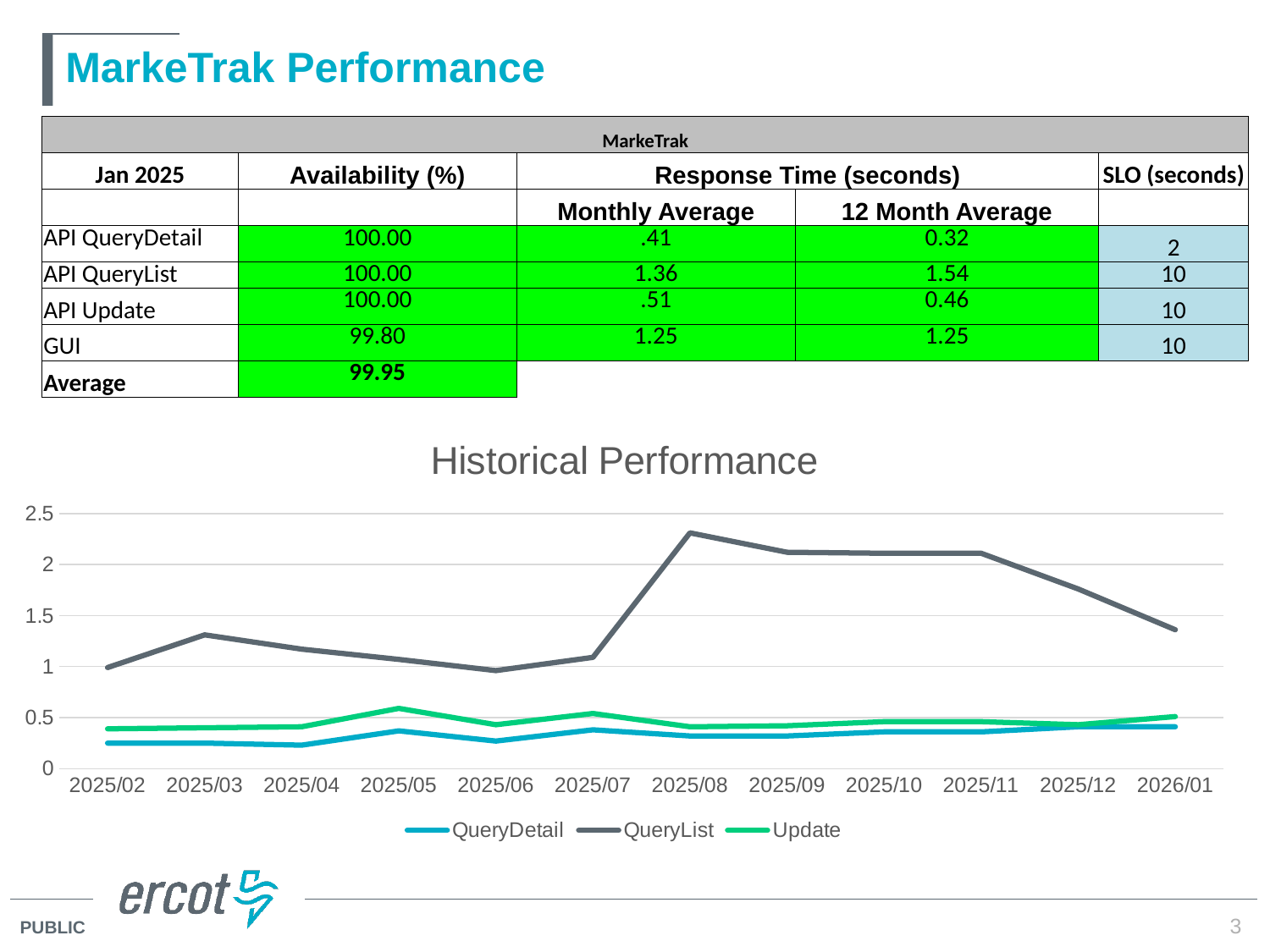
How many months are plotted along the x axis of the Historical Performance chart? 12 In the Historical Performance chart, is the QueryList value for 2025/08 greater or less than 2? greater In the Historical Performance chart, is the QueryDetail value for 2025/02 greater or less than 0.5? less How many series does the legend of the Historical Performance chart list? 3 In the Historical Performance chart, which series has the lowest value at 2025/02? QueryDetail In the Historical Performance chart, is the QueryList value for 2025/03 greater or less than 1? greater In the Historical Performance chart, does the QueryList line rise or fall from 2025/11 to 2026/01? fall What kind of chart is the Historical Performance chart? line chart What is the title of the line chart on the slide? Historical Performance In the Historical Performance chart, which series has the highest values across the period? QueryList Which series are listed in the legend of the Historical Performance chart? QueryDetail, QueryList, Update In the Historical Performance chart, which series has the larger value at 2025/08, QueryList or Update? QueryList